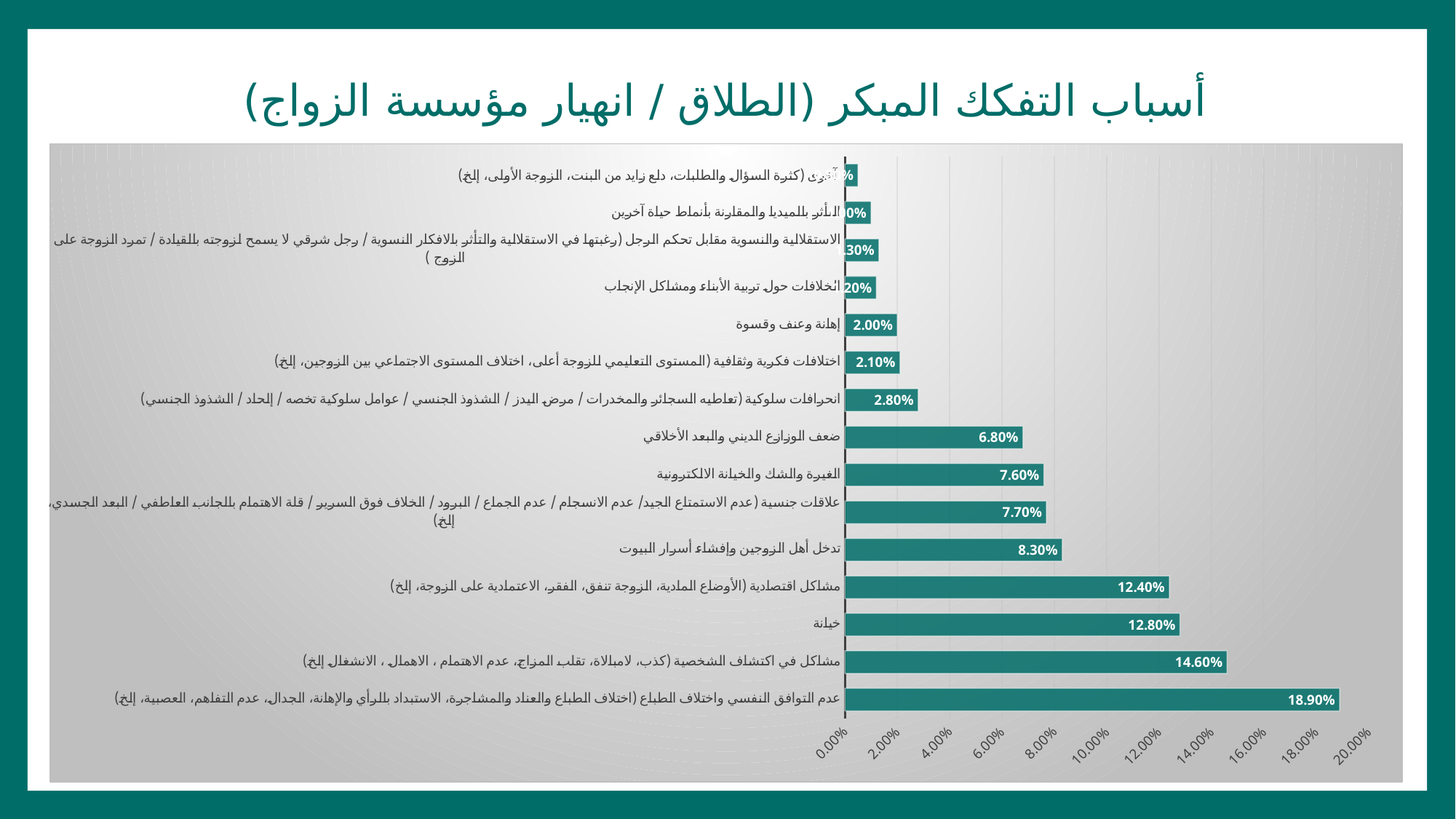
What is the value for إهانة وعنف وقسوة? 2.00% What is the difference between the values for الغيرة والشك والخيانة الالكترونية and انحرافات سلوكية? 4.80% What type of chart is shown on the slide? bar chart What is the value for ضعف الوازع الديني والبعد الأخلاقي? 6.80% What is the value for خيانة? 12.80% What is the value for تدخل أهل الزوجين وإفشاء أسرار البيوت? 8.30% How many categories are plotted in the chart? 15 Which is larger: the value for خيانة or the value for مشاكل اقتصادية? خيانة Is the value for الغيرة والشك والخيانة الالكترونية greater or less than 6.00%? greater What is the maximum value shown on the horizontal axis? 20.00% What is the difference between the values for عدم التوافق النفسي واختلاف الطباع and مشاكل في اكتشاف الشخصية? 4.30% Which category has the highest value? عدم التوافق النفسي واختلاف الطباع